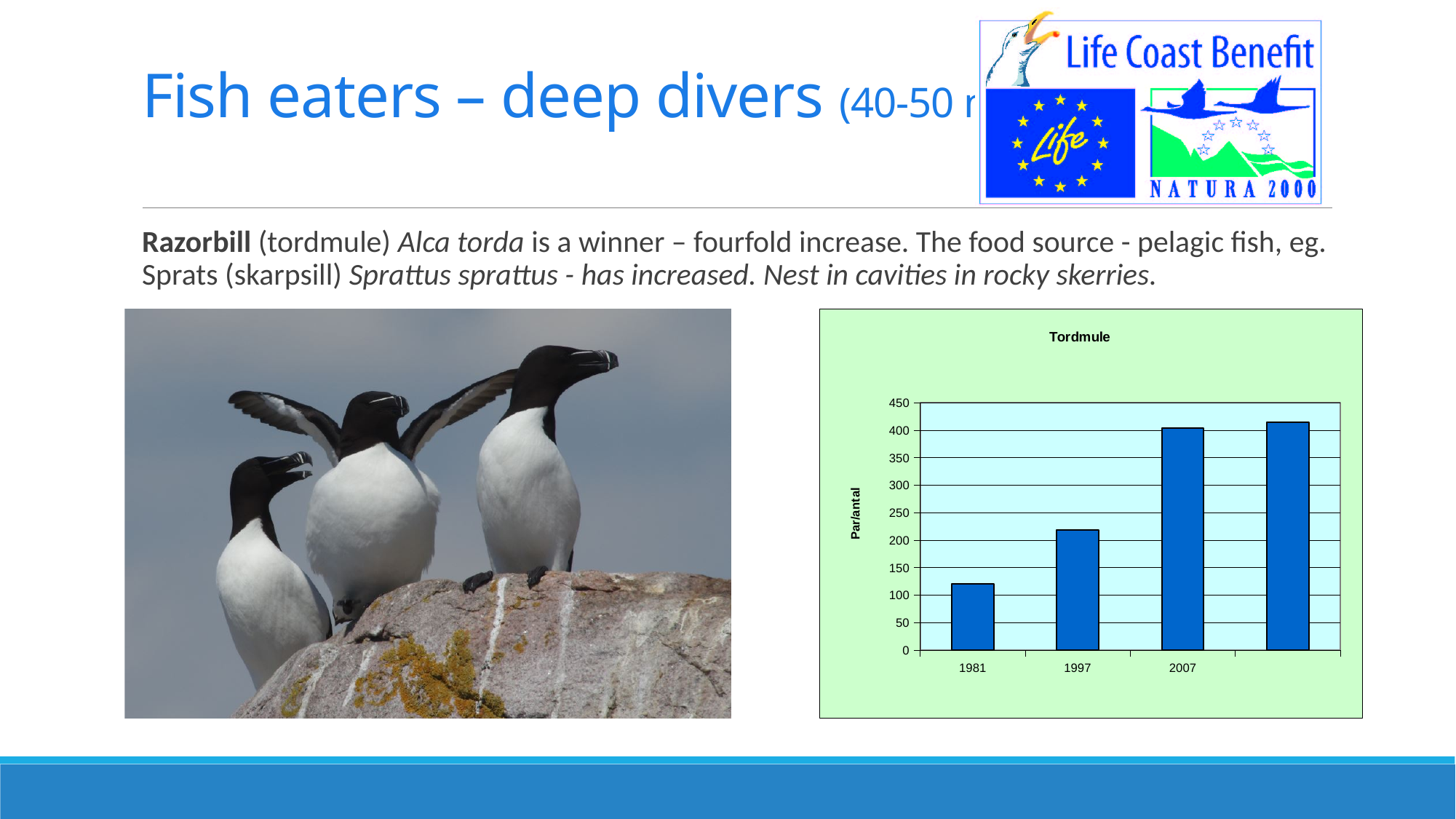
What is the label on the vertical axis of the chart? Par/antal What is the title of the chart? Tordmule How many bars are plotted in the chart? 4 Is the value for 1981 greater or less than 150? less Which labelled year has the lowest value in the chart? 1981 What kind of chart is shown on the slide? bar chart Do the values rise or fall from left to right along the x axis? rise Is the value for 1981 greater or less than 100? greater Is the value for 1997 greater or less than 200? greater Which has the larger value, 1997 or 2007? 2007